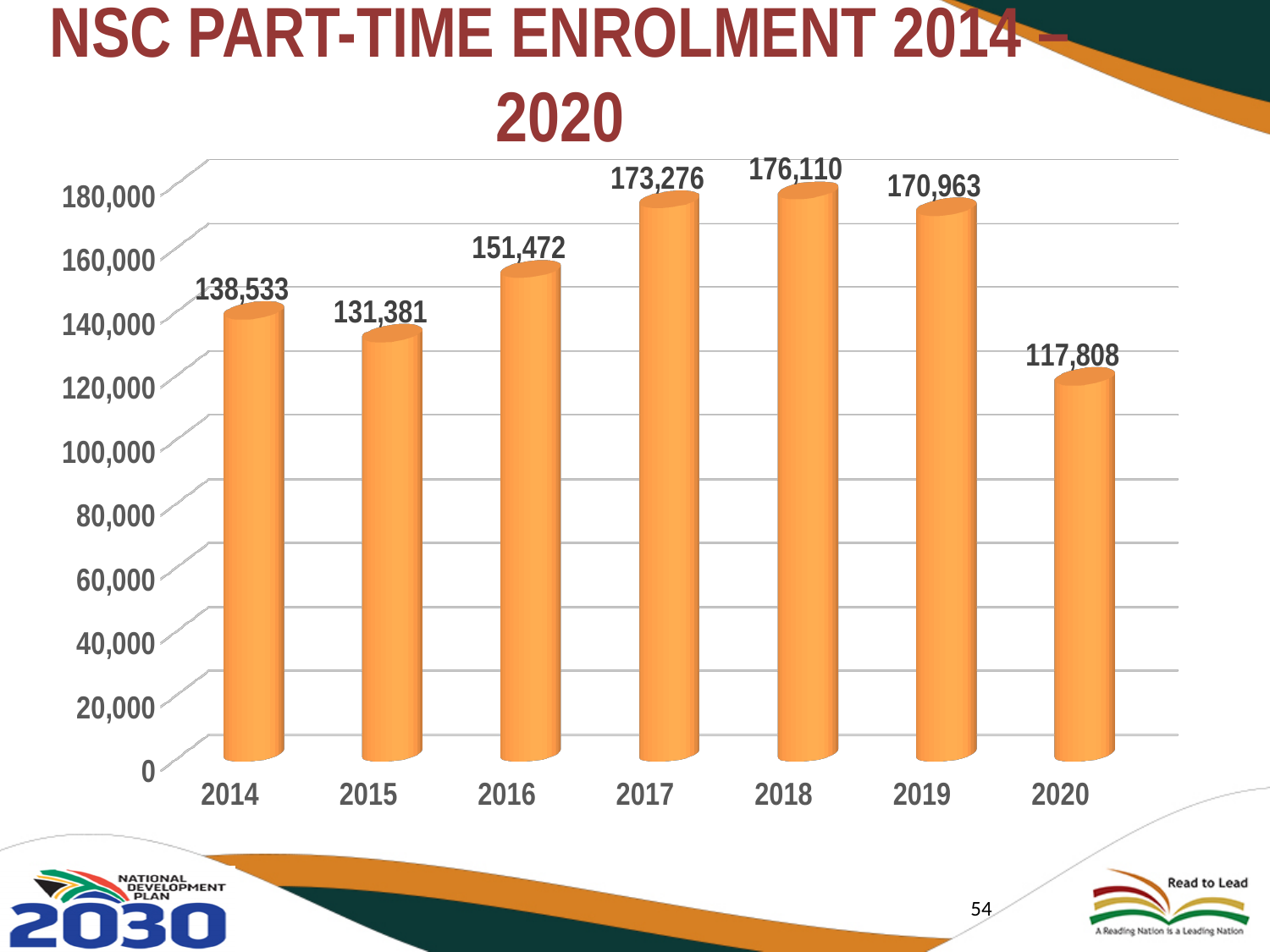
What is the difference between the enrolment in 2018 and the enrolment in 2020? 58,302 Which year had the lowest NSC part-time enrolment? 2020 What was the NSC part-time enrolment in 2020? 117,808 What was the NSC part-time enrolment in 2017? 173,276 Which year had a larger enrolment, 2014 or 2015? 2014 How many years are shown on the chart? 7 Is the enrolment for 2019 greater or less than 160,000? greater Did the NSC part-time enrolment rise or fall from 2018 to 2020? Fall Which year had the highest NSC part-time enrolment? 2018 What was the NSC part-time enrolment in 2014? 138,533 What is the difference between the enrolment in 2016 and the enrolment in 2015? 20,091 What kind of chart is shown on the slide? Bar chart